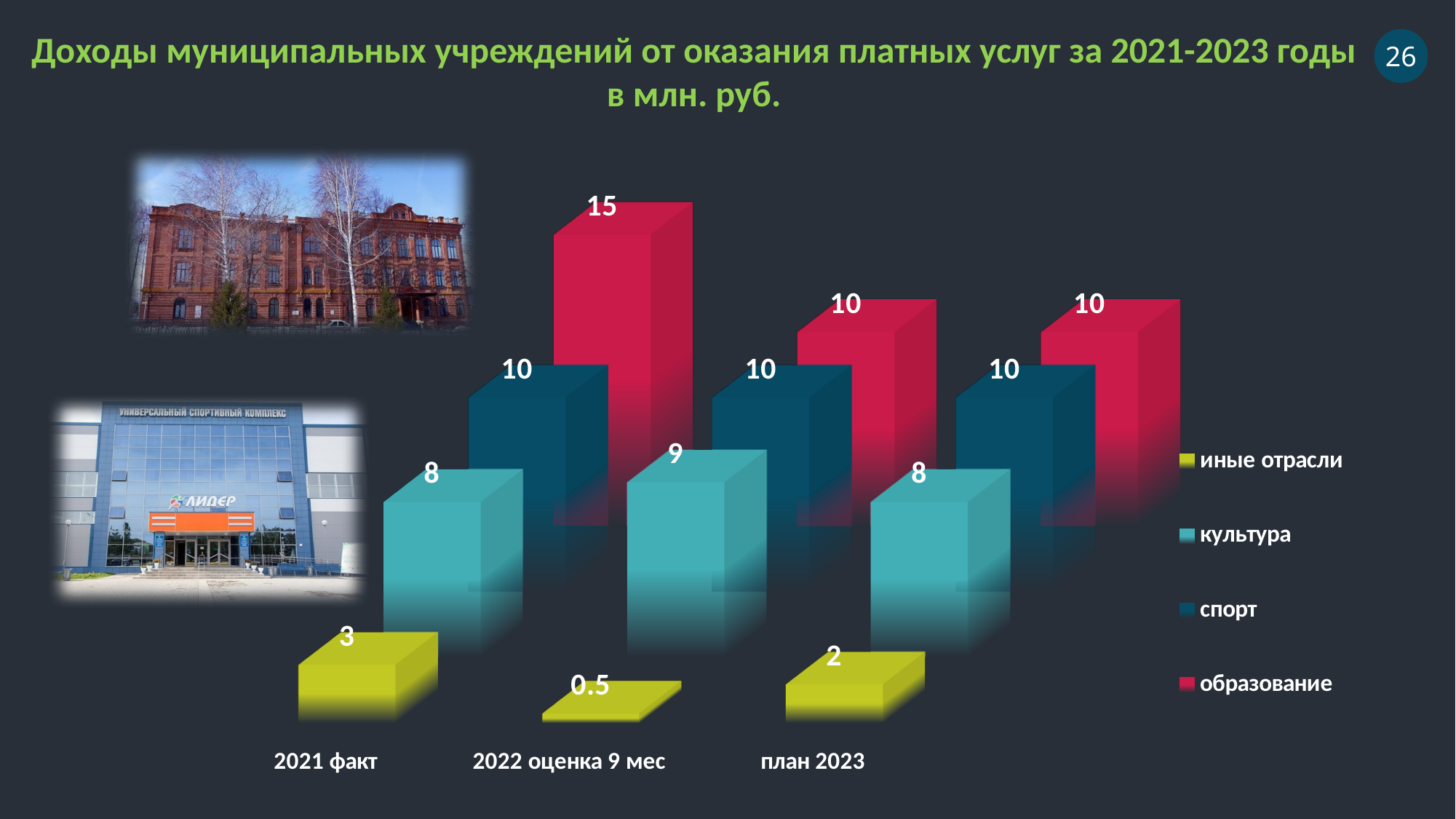
In which period is the value for иные отрасли lowest? 2022 оценка 9 мес What is the value for иные отрасли in 2022 оценка 9 мес? 0.5 What is the value for культура in план 2023? 8 What is the value for образование in 2021 факт? 15 How many periods are shown on the x axis? 3 Which series is shown in red in the legend? образование What kind of chart is shown on the slide? bar chart In which period is the value for образование highest? 2021 факт What is the value for спорт in 2022 оценка 9 мес? 10 What is the difference between образование in 2021 факт and образование in план 2023? 5 Which is larger: культура in 2022 оценка 9 мес or культура in 2021 факт? культура in 2022 оценка 9 мес How many series does the legend list? 4